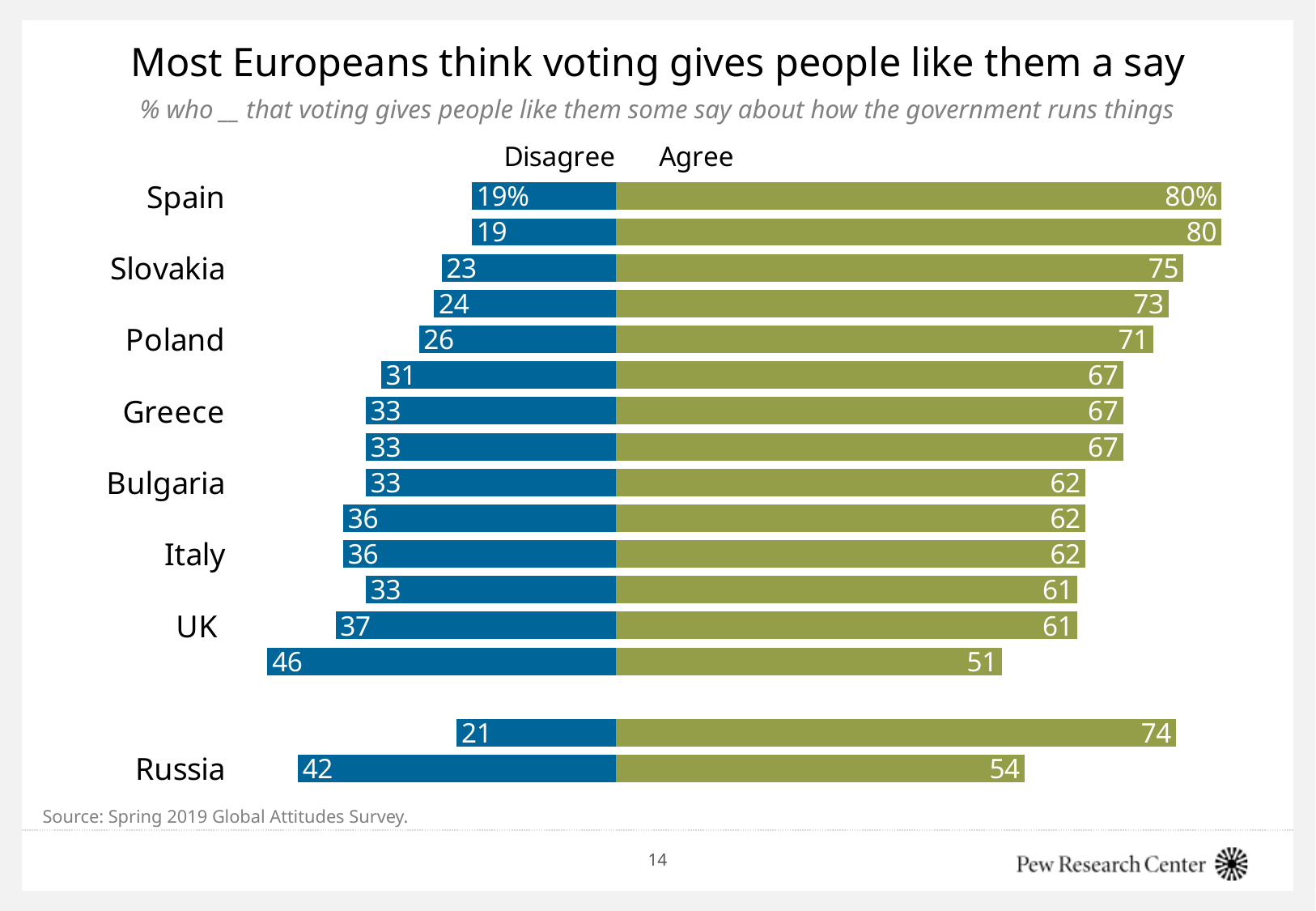
How many series does the chart show? 2 What is the Agree value for Italy? 62 What kind of chart is shown on the slide? Bar chart What are the two series labels shown above the bars? Disagree and Agree What is the Agree value for Poland? 71 What is the Disagree value for Slovakia? 23 Which labeled country has the lowest Disagree value? Spain What percentage of people in Spain agree that voting gives people like them some say? 80% What is the Disagree value for the UK? 37 What is the difference between the Disagree values for Poland and Slovakia? 3 Which has a higher Agree value, Greece or Bulgaria? Greece What is the difference between the Agree and Disagree values for Spain? 61